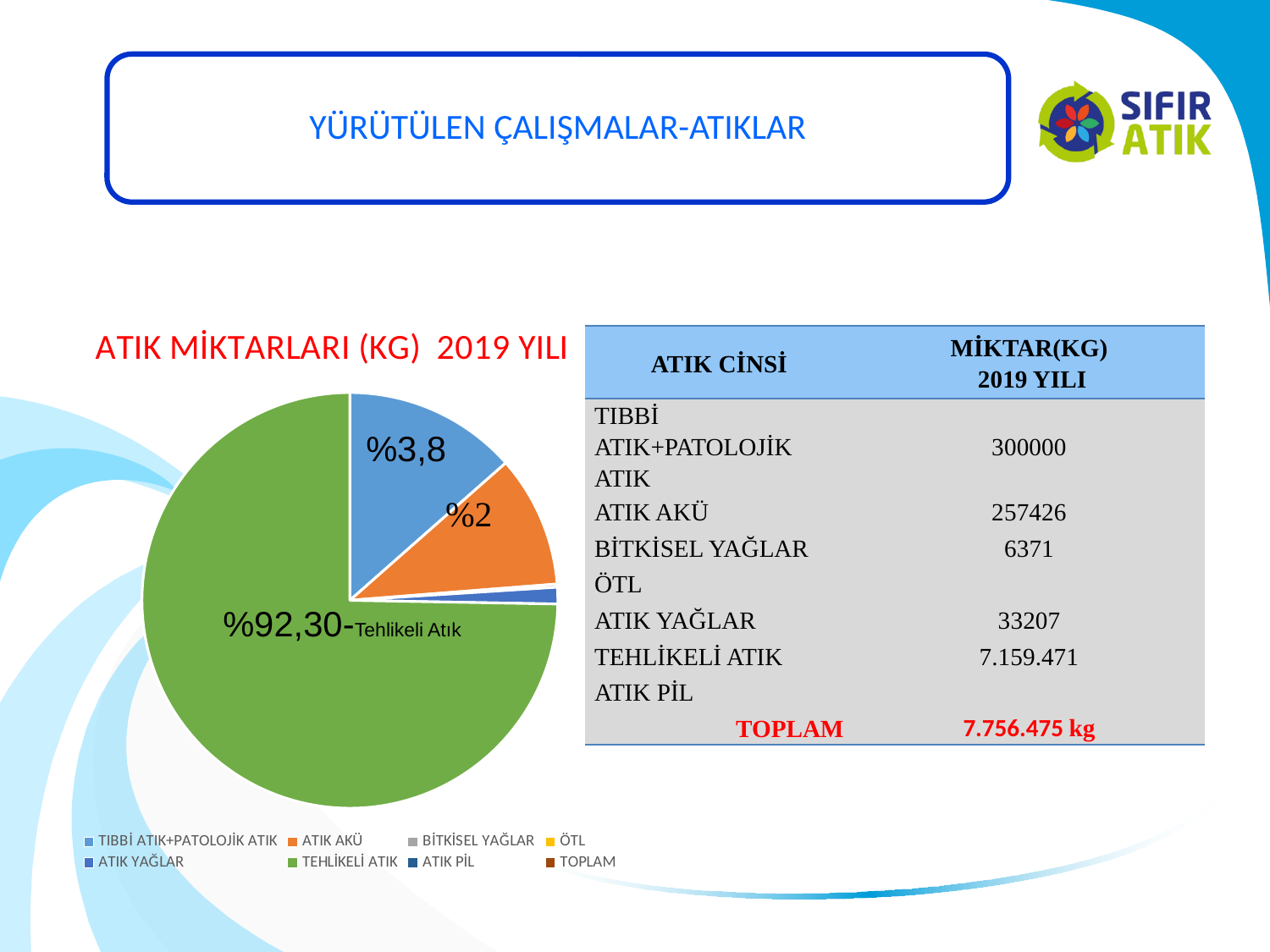
Which category has the largest slice of the pie? TEHLİKELİ ATIK How many entries does the pie chart's legend list? 8 What kind of chart is shown on the slide? pie chart What share of the pie is labelled on the ATIK AKÜ slice? %2 What colour is the TEHLİKELİ ATIK slice in the pie chart? green What is the difference between the labelled shares of TIBBİ ATIK+PATOLOJİK ATIK and ATIK AKÜ? %1,8 Which slice is larger, TIBBİ ATIK+PATOLOJİK ATIK or ATIK AKÜ? TIBBİ ATIK+PATOLOJİK ATIK Is the share for TEHLİKELİ ATIK greater or less than 50%? greater What is the title of the pie chart? ATIK MİKTARLARI (KG) 2019 YILI What share of the pie is labelled for TEHLİKELİ ATIK? %92,30 What share of the pie is labelled on the TIBBİ ATIK+PATOLOJİK ATIK slice? %3,8 Which slice is larger, TEHLİKELİ ATIK or ATIK AKÜ? TEHLİKELİ ATIK